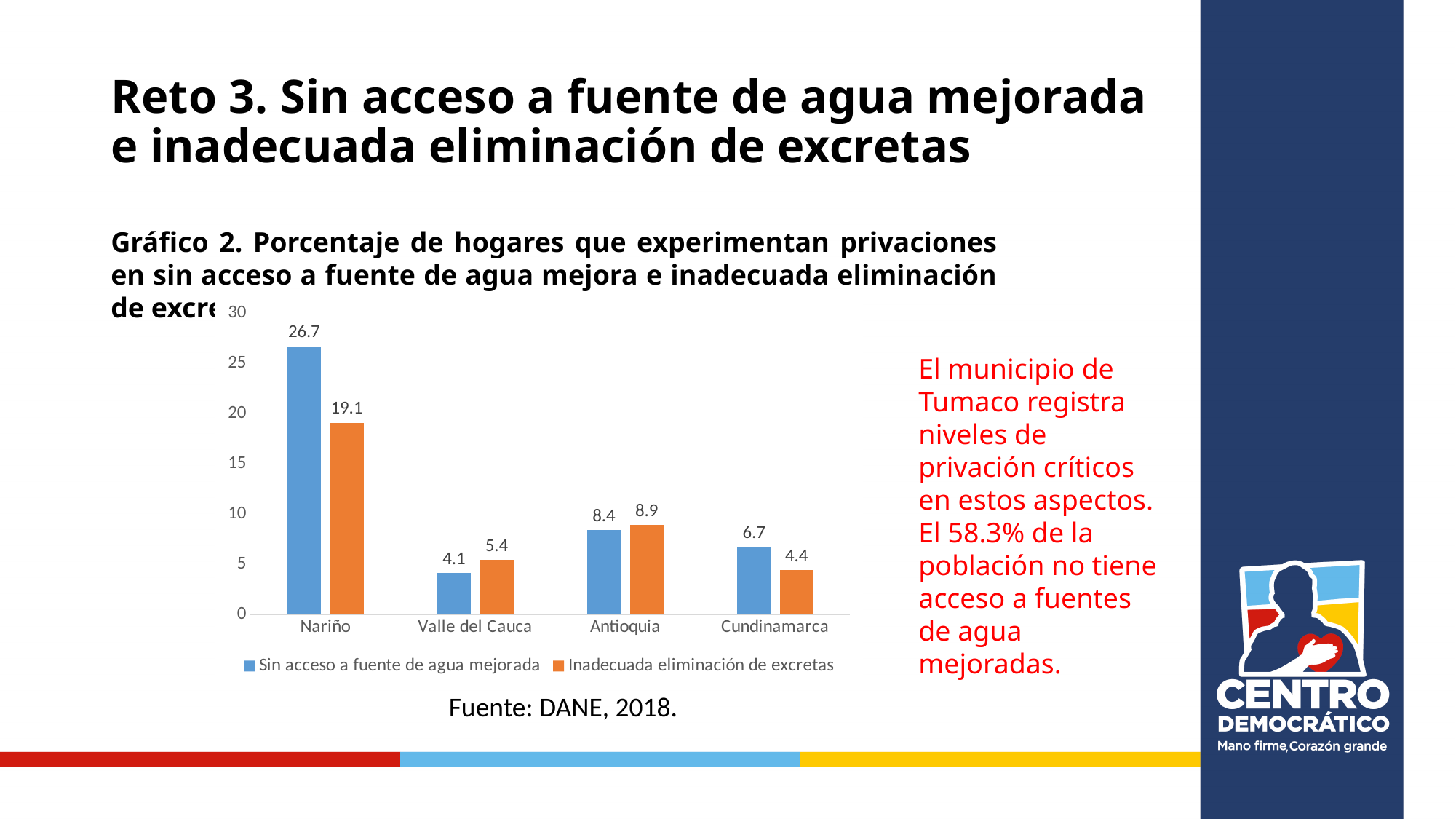
What is the value for Nariño in the 'Sin acceso a fuente de agua mejorada' series? 26.7 How many departments are shown on the x axis of the chart? 4 For Cundinamarca, which series has the larger value: 'Sin acceso a fuente de agua mejorada' or 'Inadecuada eliminación de excretas'? Sin acceso a fuente de agua mejorada What is the difference between the two series values for Nariño? 7.6 Which department has the lowest value for 'Sin acceso a fuente de agua mejorada'? Valle del Cauca Is the value for Antioquia in the 'Inadecuada eliminación de excretas' series greater or less than 10? less What colour are the bars for the 'Inadecuada eliminación de excretas' series? Orange What is the value for Valle del Cauca in the 'Inadecuada eliminación de excretas' series? 5.4 What is the value for Cundinamarca in the 'Sin acceso a fuente de agua mejorada' series? 6.7 How many series does the chart legend list? 2 Which department has the highest value for 'Inadecuada eliminación de excretas'? Nariño What kind of chart is shown on the slide? Bar chart